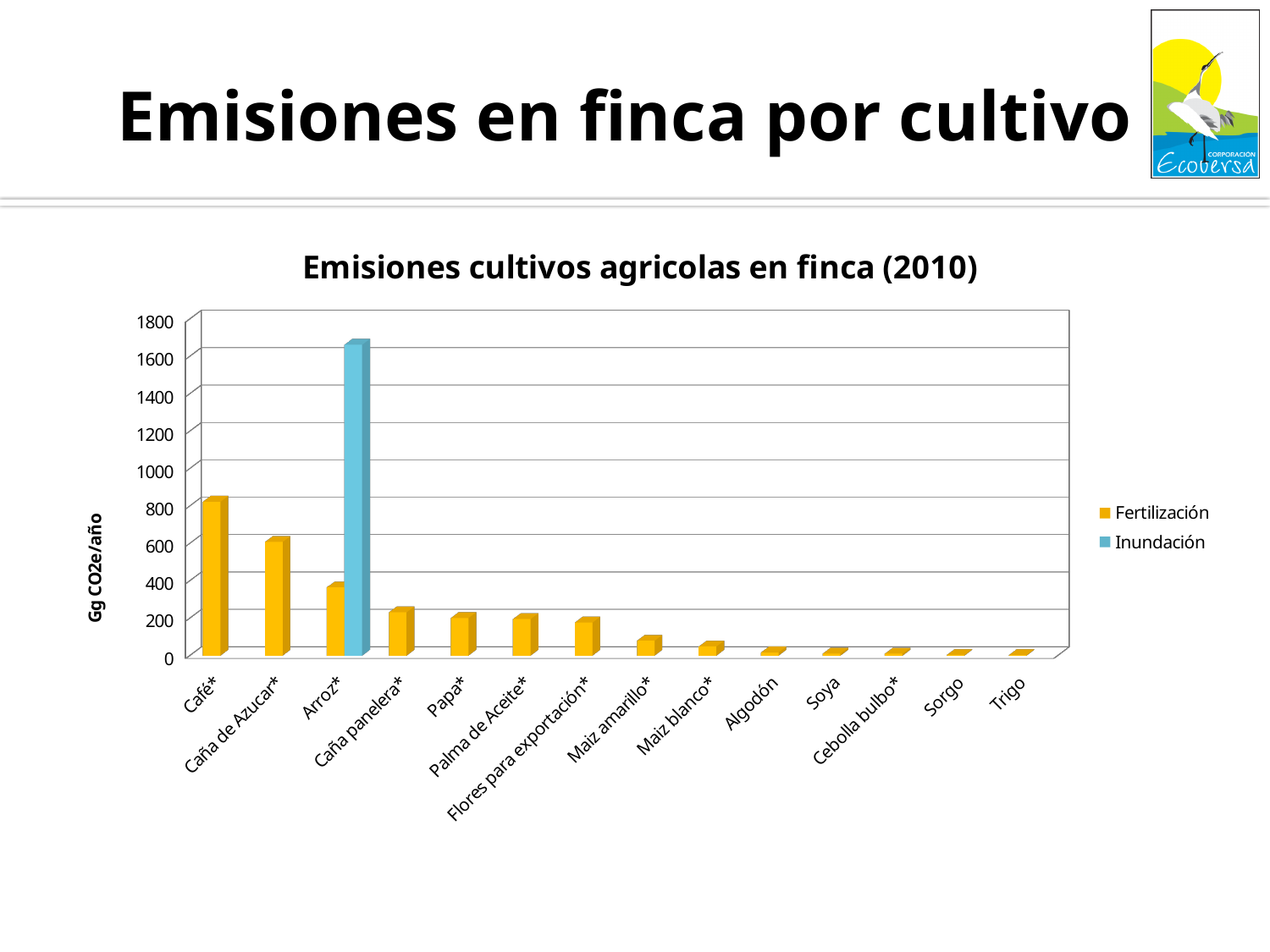
Is the Fertilización value for Caña de Azucar* greater or less than 800? less Which crop is the only one with an Inundación bar? Arroz* Which is larger: the Inundación value for Arroz* or the Fertilización value for Café*? Inundación value for Arroz* How many series does the chart legend list? 2 How many crop categories are shown on the x axis of the chart? 14 Do the Fertilización values generally rise or fall moving from left to right along the x axis? fall Is the Fertilización value for Maiz amarillo* greater or less than 200? less What kind of chart is shown on the slide? Bar chart Which is larger: the Fertilización value for Café* or for Caña de Azucar*? Café* Which crop has the highest Fertilización emissions? Café* Is the Fertilización value for Café* greater or less than 600? greater